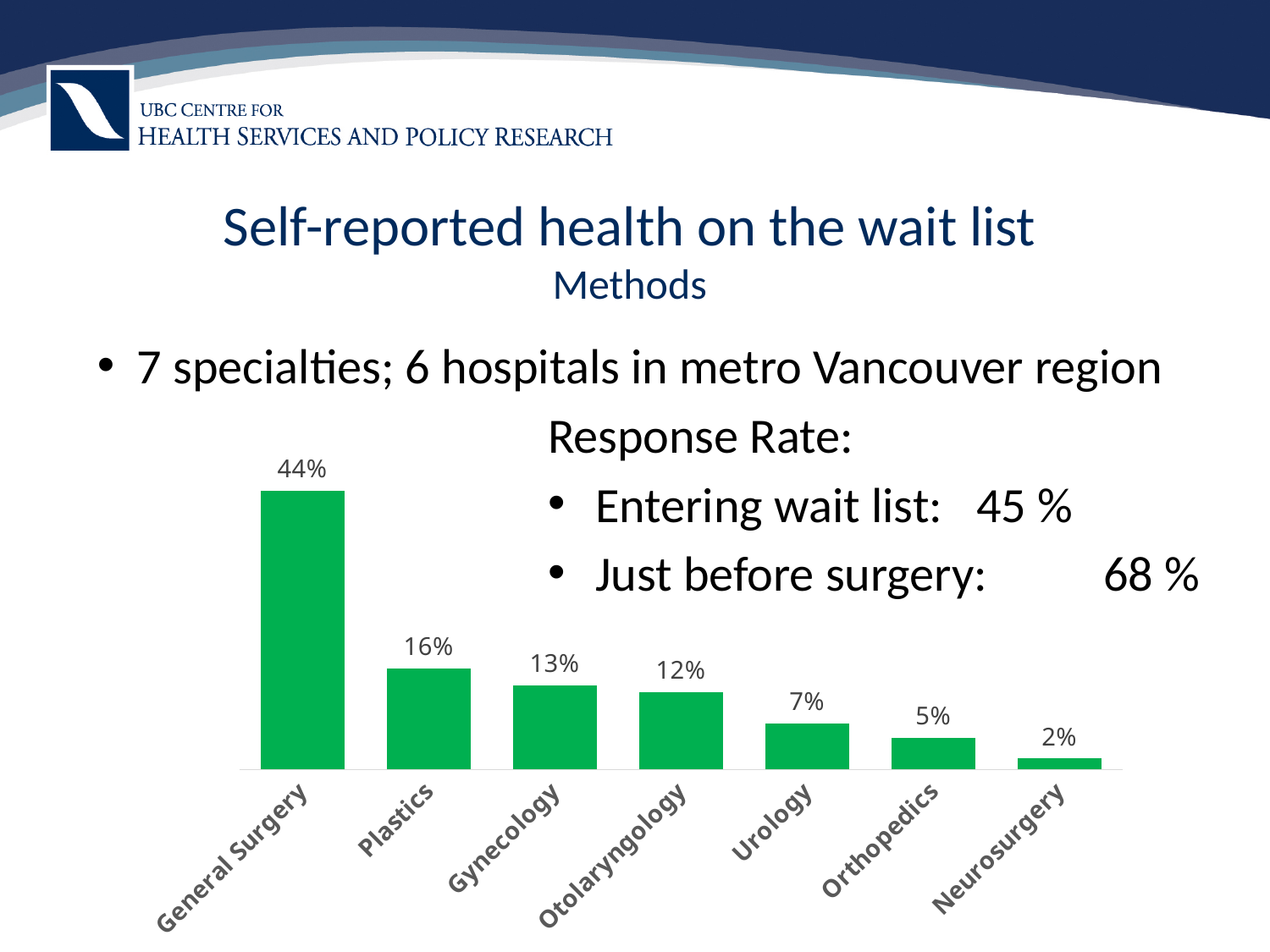
How many specialties are shown in the chart? 7 What kind of chart is shown on the slide? Bar chart Which is larger, the value for Plastics or the value for Urology? Plastics What is the difference between the values for General Surgery and Plastics? 28% What colour are the bars in the chart? Green What is the value for Otolaryngology? 12% What is the value for Orthopedics? 5% Do the values rise or fall from left to right across the chart? Fall What is the value for General Surgery? 44% Which specialty has the lowest value? Neurosurgery Which specialty has the highest value? General Surgery What is the difference between the values for Gynecology and Urology? 6%